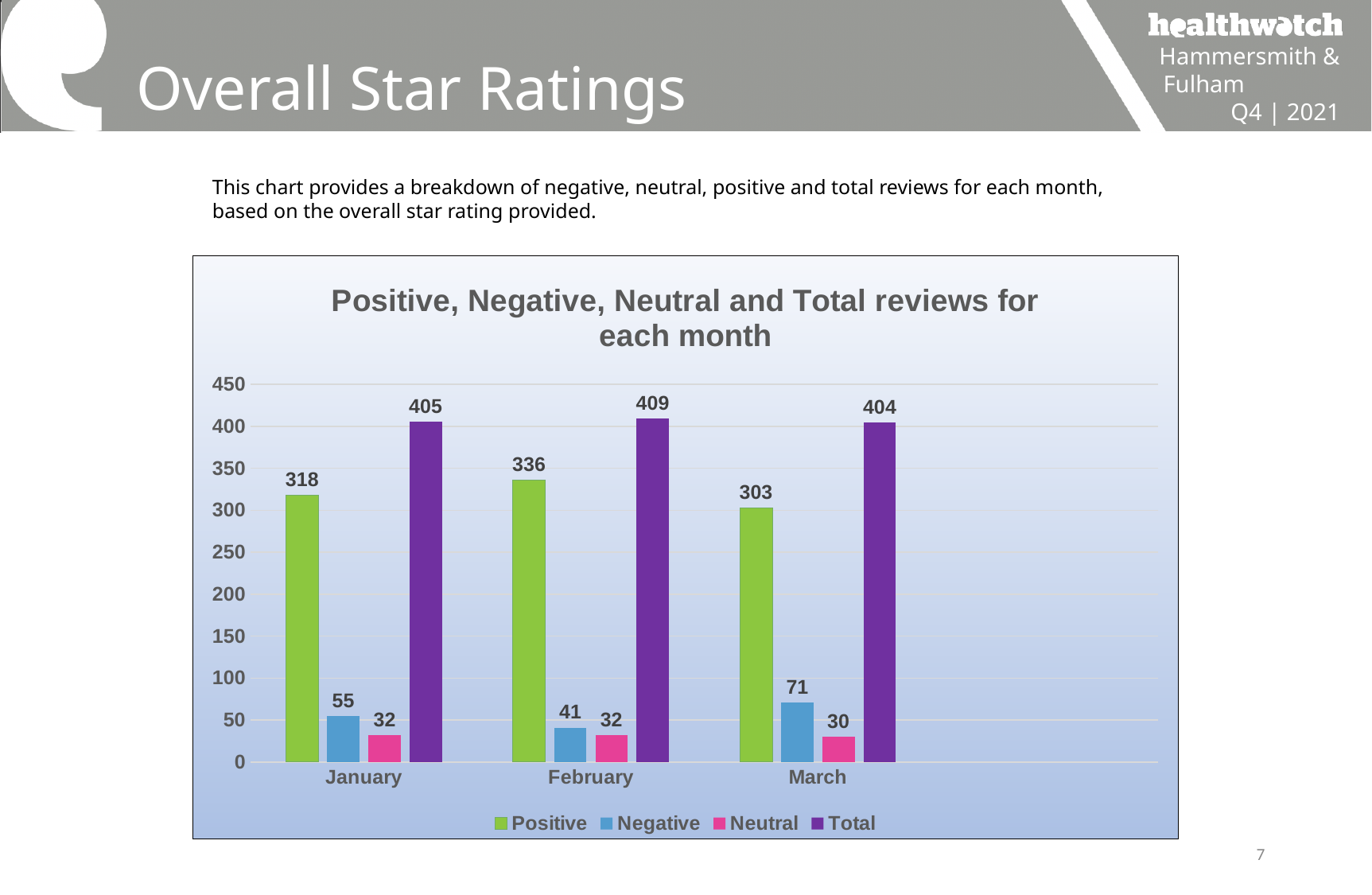
What is the number of Negative reviews in March? 71 Which month has the lowest number of Neutral reviews? March Which is larger: the number of Negative reviews in January or in February? January Is the number of Positive reviews in March greater or less than 350? less What is the number of Positive reviews in January? 318 What is the Total number of reviews in February? 409 How many series does the legend list? 4 What kind of chart is shown on the slide? bar chart How many months are shown on the x axis? 3 Which month has the highest number of Positive reviews? February What is the difference between the Total reviews in February and the Total reviews in March? 5 What colour are the Total bars in the chart? purple